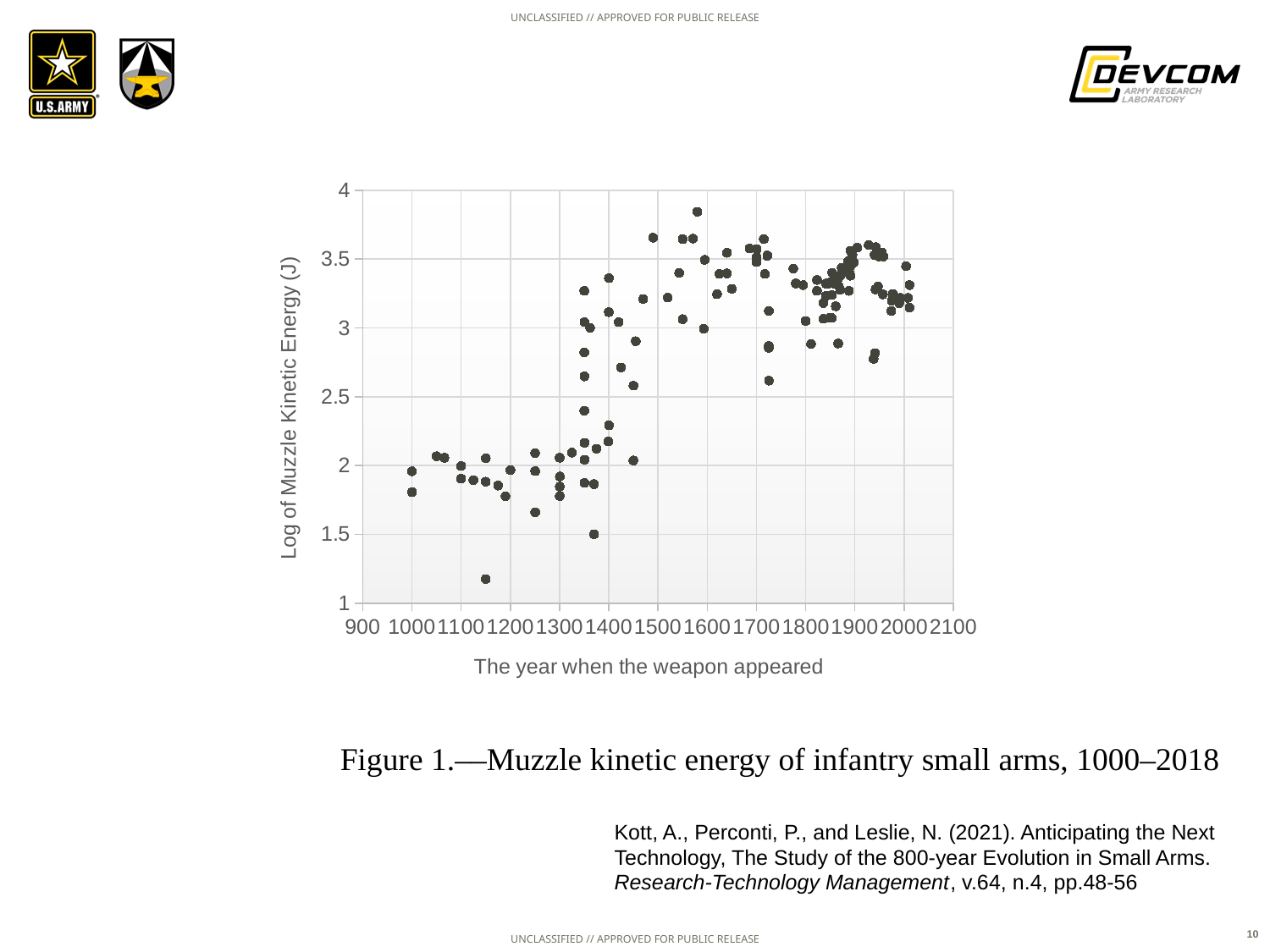
What is the label of the x axis of the chart? The year when the weapon appeared Do the plotted values generally rise or fall as the year increases along the x axis? rise Is the lowest value among points after the year 1700 greater or less than 3? less Is the value of the lowest point on the chart greater or less than 1.5? less What is the caption given for the chart on the slide? Figure 1.—Muzzle kinetic energy of infantry small arms, 1000–2018 What kind of chart is shown on the slide? scatter plot Are the values of the points near the year 2000 greater or less than 3? greater